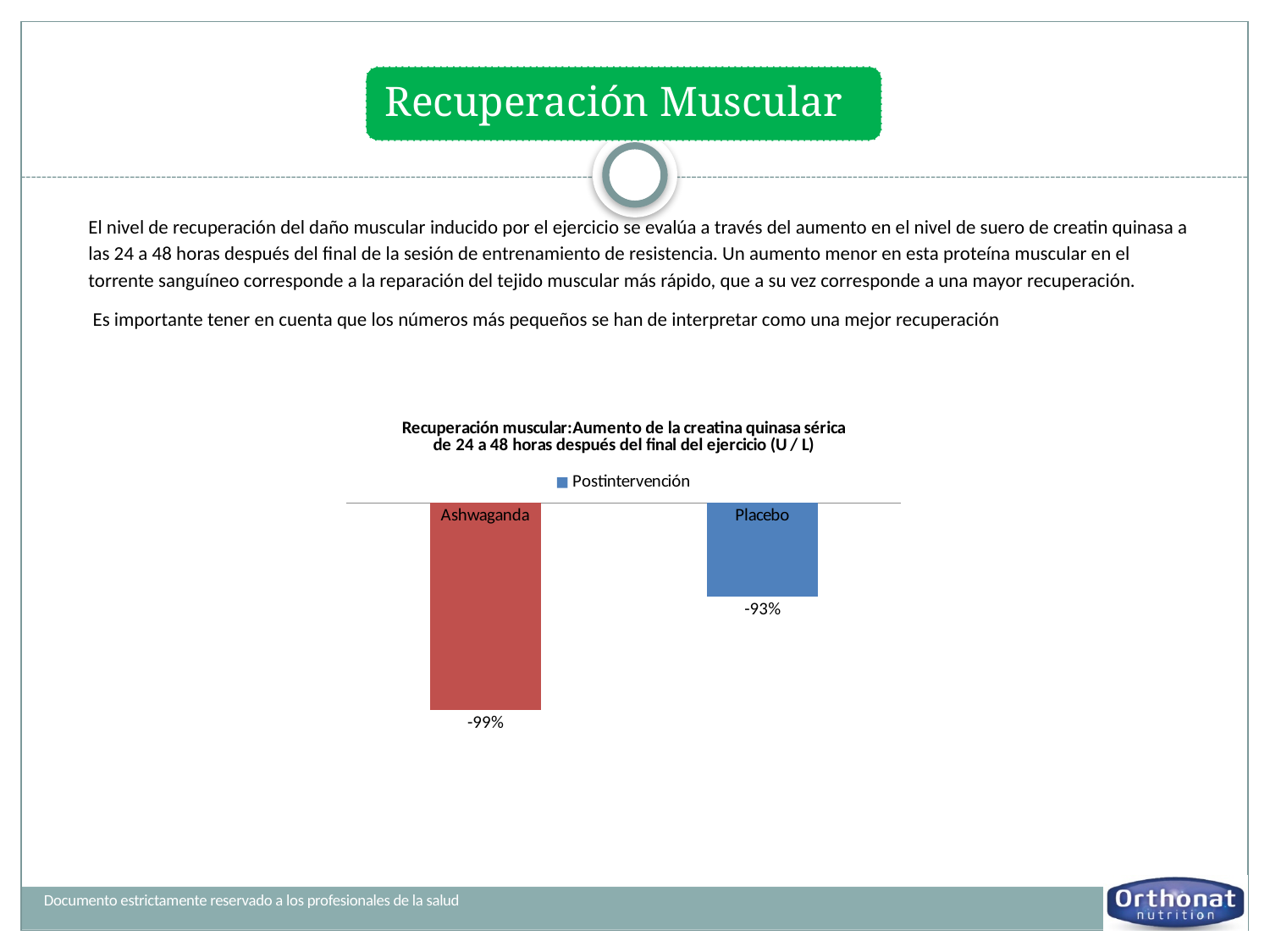
How many series does the legend list? 1 What is the difference between the Placebo value and the Ashwaganda value? 6% What colour is the Ashwaganda bar? Red What kind of chart is shown on the slide? Bar chart Which is larger, the value for Ashwaganda or the value for Placebo? Placebo What is the value for Ashwaganda? -99% Which category has the highest value? Placebo What series name is shown in the chart legend? Postintervención What is the value for Placebo? -93% How many categories are shown in the chart? 2 Which category has the lowest value? Ashwaganda